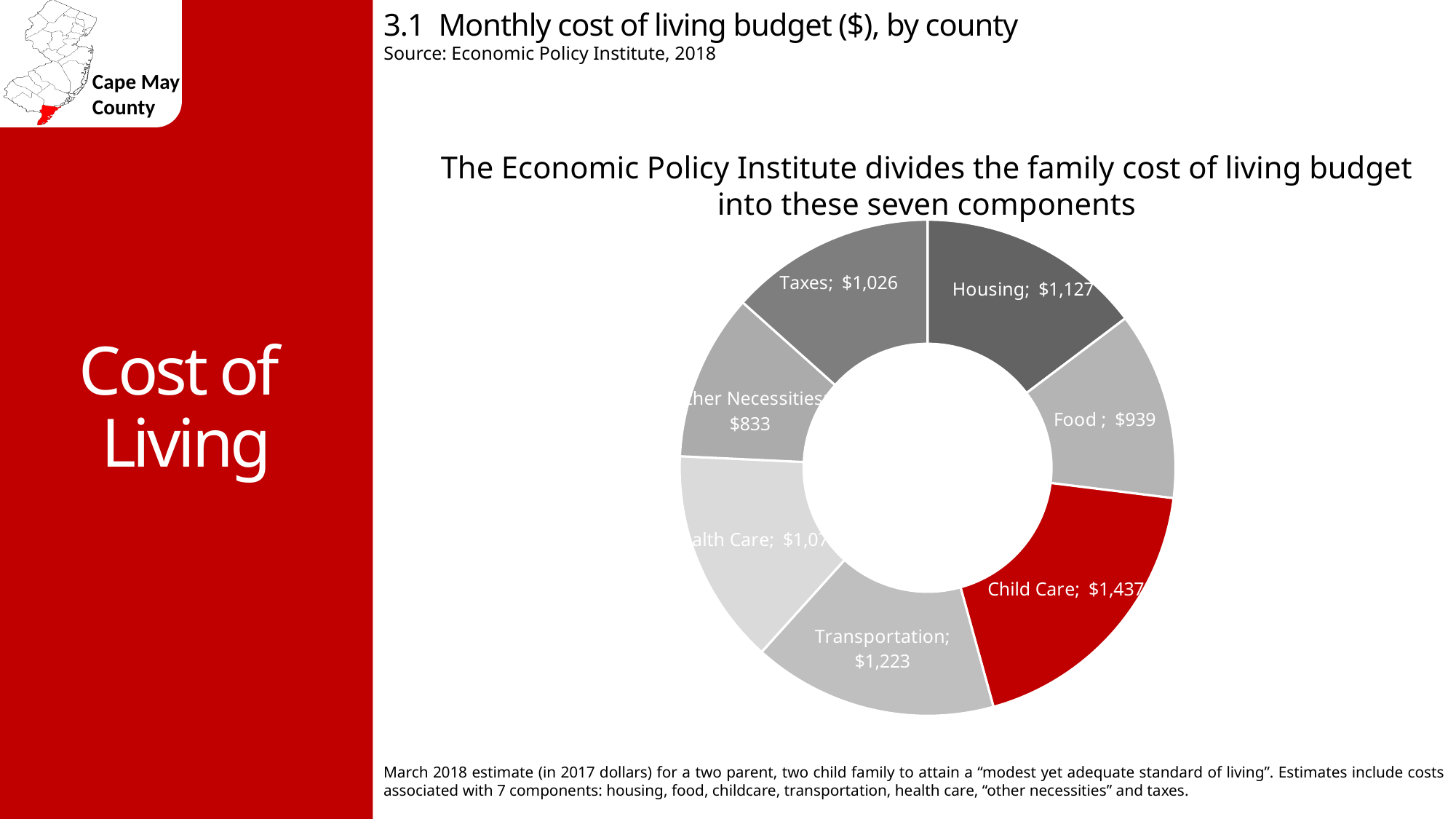
How much more is the monthly Child Care cost than the Housing cost? $310 Which component has the smallest monthly cost? Other Necessities What is the monthly Housing cost shown on the chart? $1,127 What is the monthly Other Necessities cost shown on the chart? $833 What is the monthly Taxes cost shown on the chart? $1,026 What is the monthly Child Care cost shown on the chart? $1,437 What is the monthly Transportation cost shown on the chart? $1,223 Which is larger, the Transportation cost or the Taxes cost? Transportation Which component has the largest monthly cost? Child Care How much more is the monthly Housing cost than the Food cost? $188 How many components are shown in the chart? 7 What is the monthly Food cost shown on the chart? $939